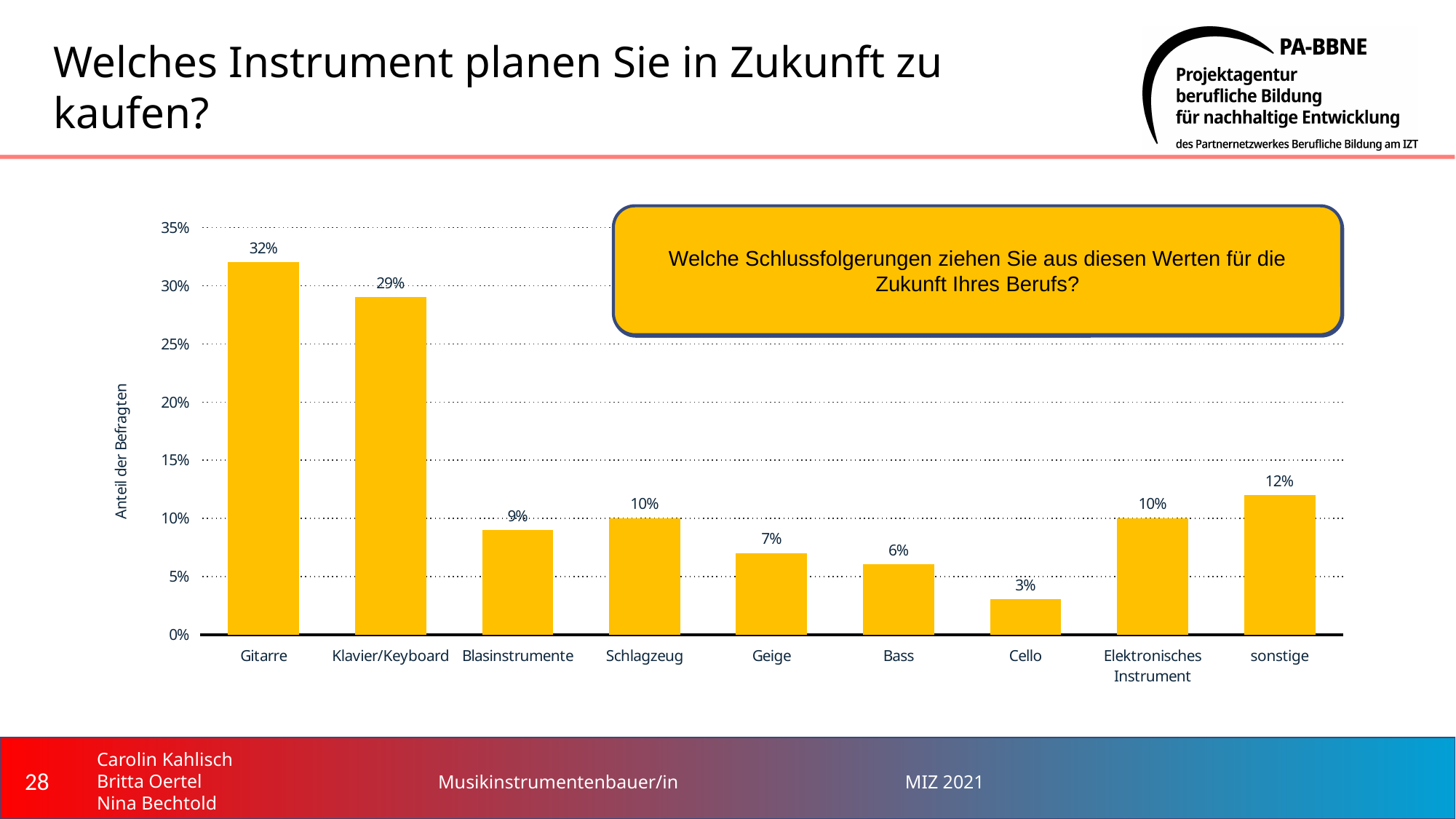
Which is larger, the value for Geige or the value for Bass? Geige What kind of chart is shown on the slide? Bar chart How many categories are shown on the x axis? 9 What is the difference between the values for Gitarre and Klavier/Keyboard? 3% What is the label of the y axis? Anteil der Befragten Which category has the highest value? Gitarre Which category has the lowest value? Cello What is the value for Gitarre? 32% What is the value for Klavier/Keyboard? 29% What is the value for Cello? 3% What is the value for Elektronisches Instrument? 10% What is the difference between the values for sonstige and Bass? 6%